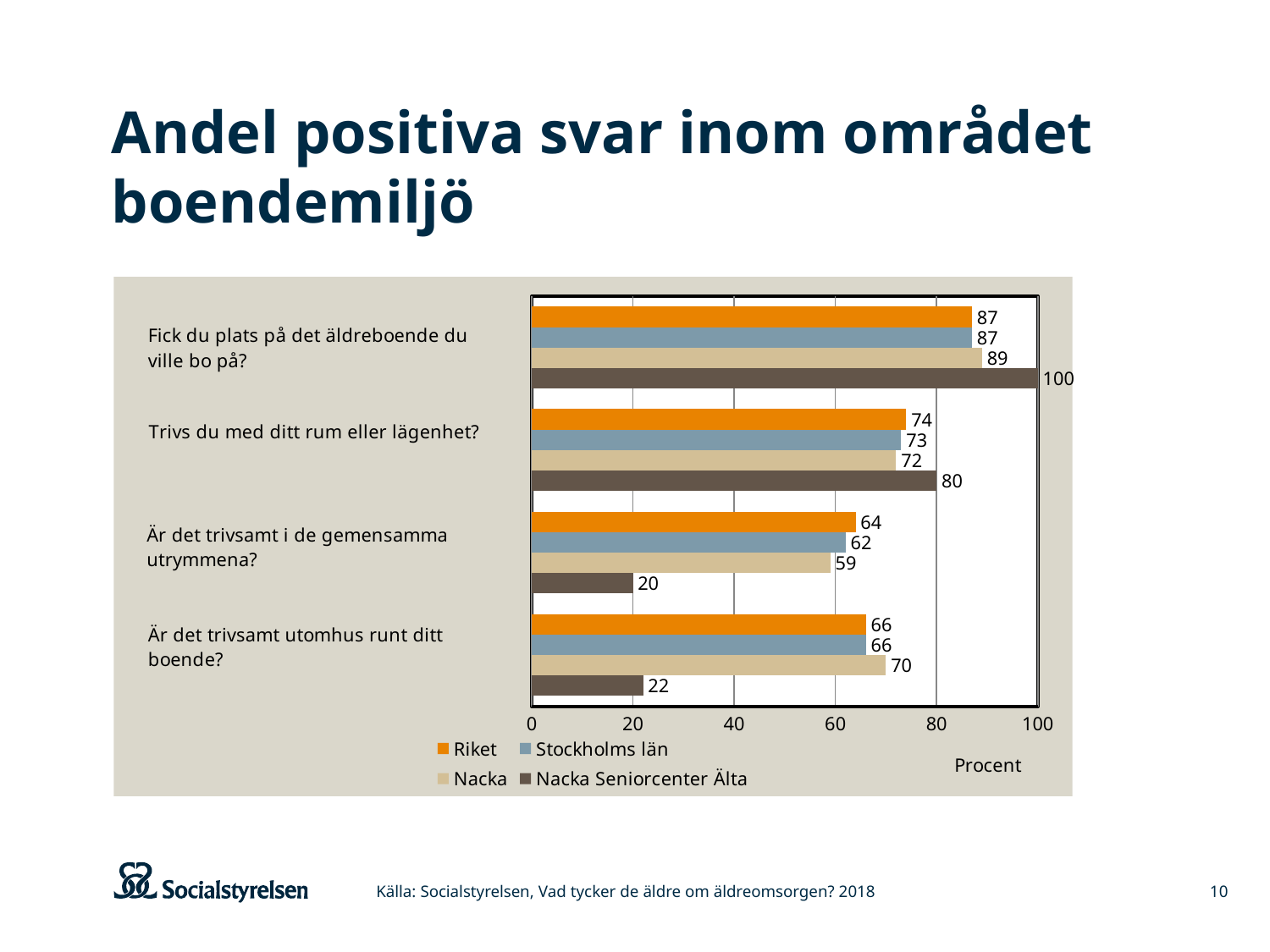
What kind of chart is shown on the slide? Bar chart Which question has the highest value for Riket? Fick du plats på det äldreboende du ville bo på? What is the value for Nacka on "Är det trivsamt i de gemensamma utrymmena?"? 59 What is the difference between Nacka Seniorcenter Älta and Riket on "Trivs du med ditt rum eller lägenhet?"? 6 How many questions (categories) are shown on the chart? 4 On "Är det trivsamt utomhus runt ditt boende?", which is larger: Nacka or Nacka Seniorcenter Älta? Nacka What is the value for Stockholms län on "Är det trivsamt utomhus runt ditt boende?"? 66 What is the value for Nacka Seniorcenter Älta on "Fick du plats på det äldreboende du ville bo på?"? 100 What is the label on the horizontal axis of the chart? Procent How many series does the legend list? 4 What is the value for Riket on "Trivs du med ditt rum eller lägenhet?"? 74 Which question has the lowest value for Nacka Seniorcenter Älta? Är det trivsamt i de gemensamma utrymmena?